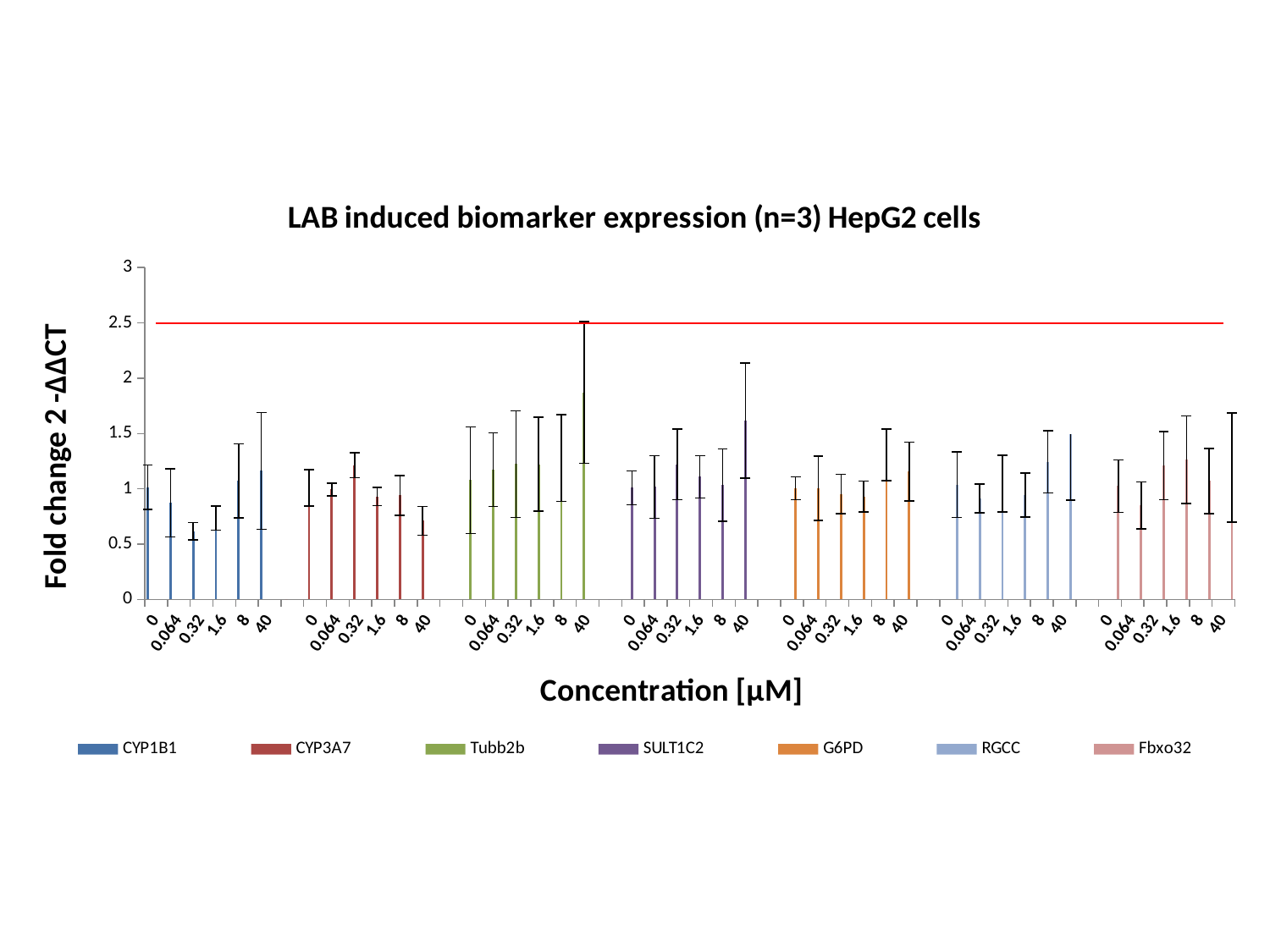
Is the value for SULT1C2 at 40 µM greater or less than 1.5? greater How many concentration levels are plotted for each series? 6 Is the value for Tubb2b at 40 µM greater or less than 1.5? greater Is the value for Tubb2b at 0.32 µM greater or less than 1? greater Which series has the tallest bar in the chart? Tubb2b Which is larger: the value for Tubb2b at 40 µM or the value for CYP1B1 at 0.32 µM? Tubb2b at 40 µM What is the label of the x axis? Concentration [µM] How many series does the legend list? 7 What kind of chart is shown on the slide? bar chart What is the title of the chart? LAB induced biomarker expression (n=3) HepG2 cells